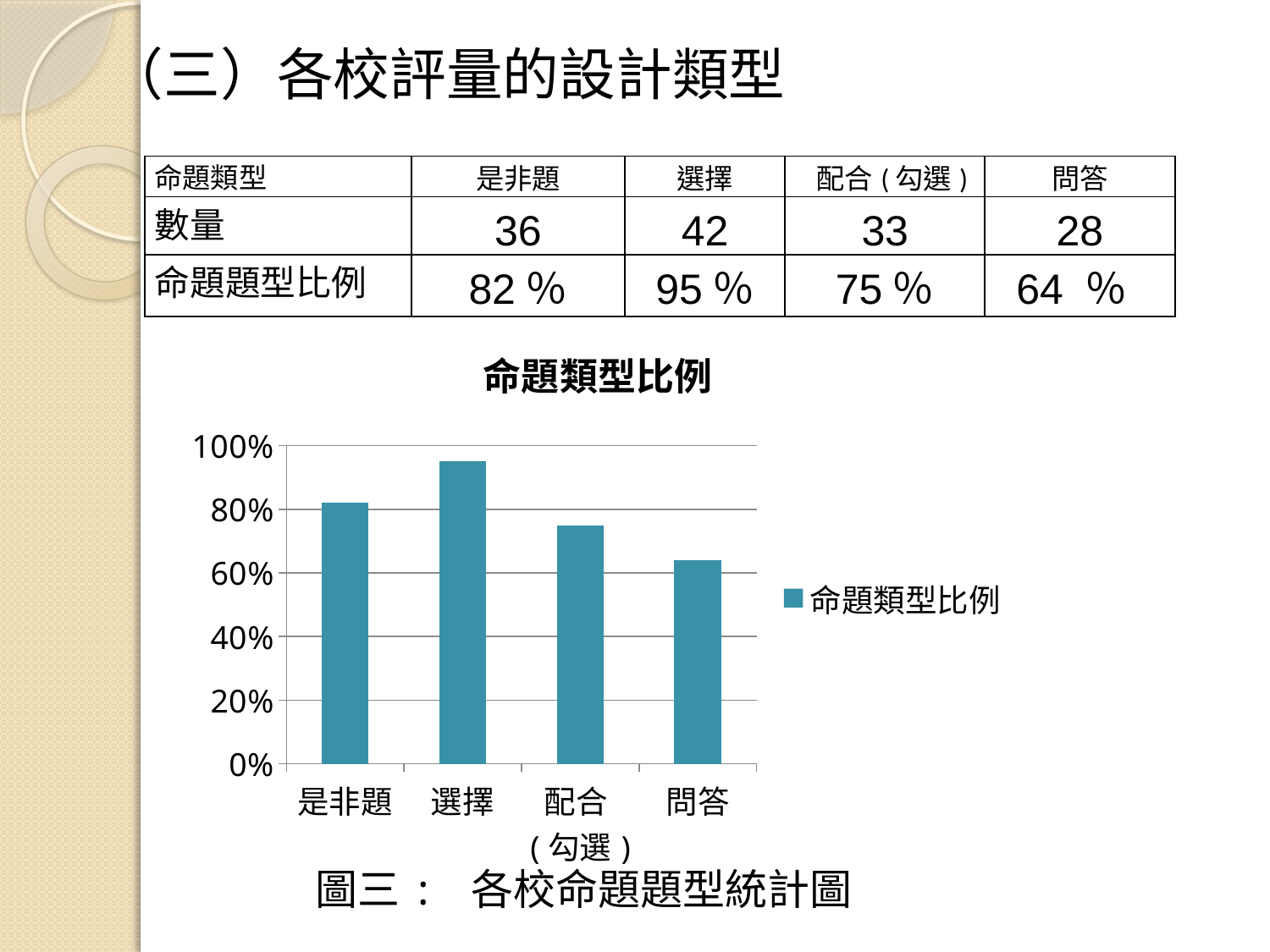
How many series does the chart legend list? 1 Is the value for 問答 greater or less than 80%? less Is the value for 選擇 greater or less than 80%? greater What is the difference between the 命題題型比例 for 選擇 and for 問答, using the values printed in the table? 31 % What type of chart is shown on the slide? bar chart Which category has the highest bar in the chart? 選擇 What is the 命題題型比例 value for 選擇 as printed in the table? 95 % How many categories are shown on the x axis of the chart? 4 What is the title of the chart? 命題類型比例 Which category has the lowest bar in the chart? 問答 Which is larger, the bar for 是非題 or the bar for 配合（勾選）? 是非題 Is the value for 配合（勾選） greater or less than 60%? greater